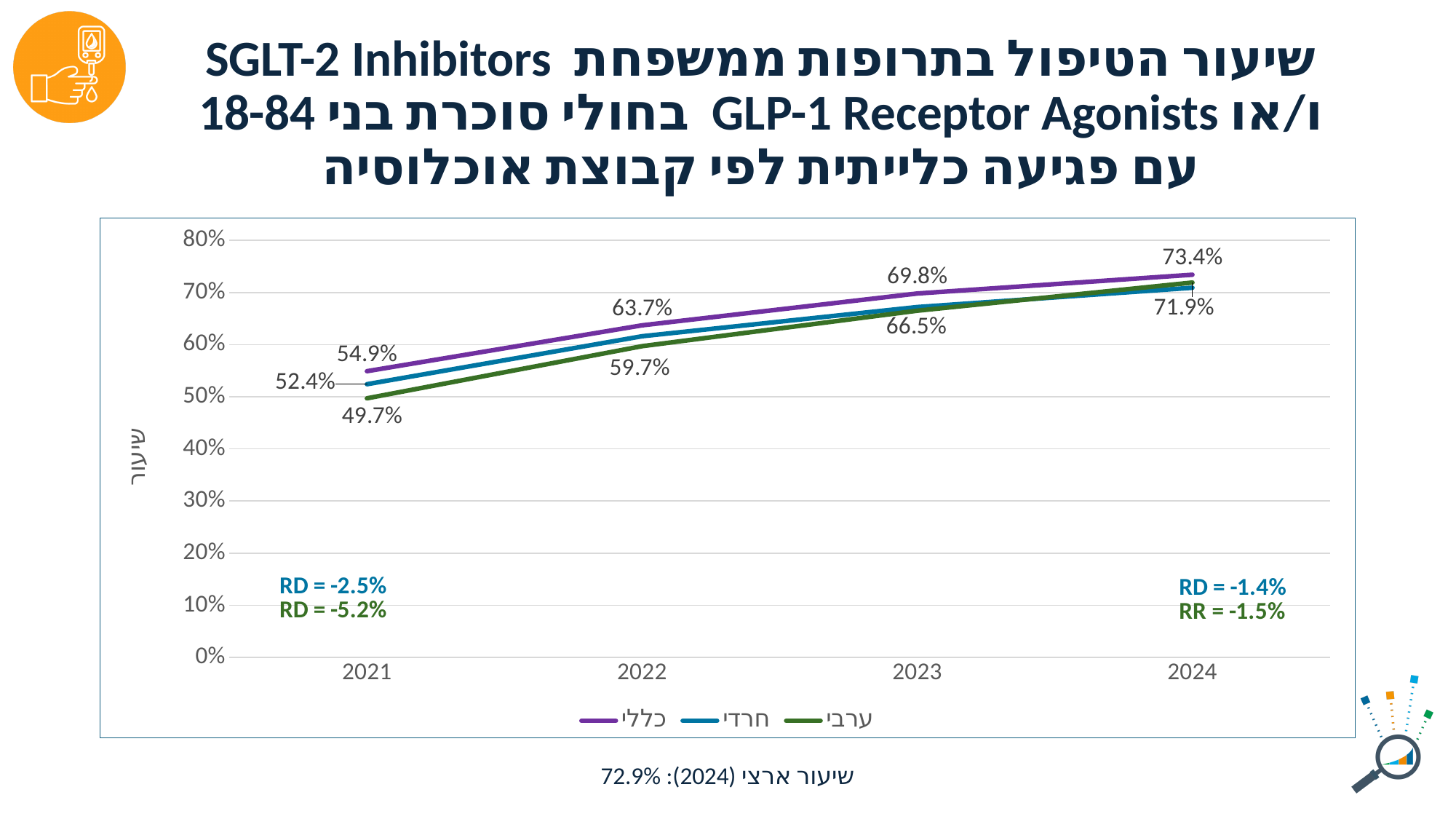
What is the value for כללי in 2021? 54.9% What kind of chart is shown on the slide? line chart What is the value for ערבי in 2022? 59.7% Is the value for חרדי in 2023 greater or less than 60%? greater How many years are shown on the x axis? 4 Which series has the lowest value in 2021? ערבי What is the value for חרדי in 2021? 52.4% Do the values for כללי rise or fall from 2021 to 2024? rise What is the difference between the כללי and ערבי values in 2021? 5.2 percentage points How many series does the legend list? 3 What is the value for ערבי in 2021? 49.7% What is the value for כללי in 2024? 73.4%